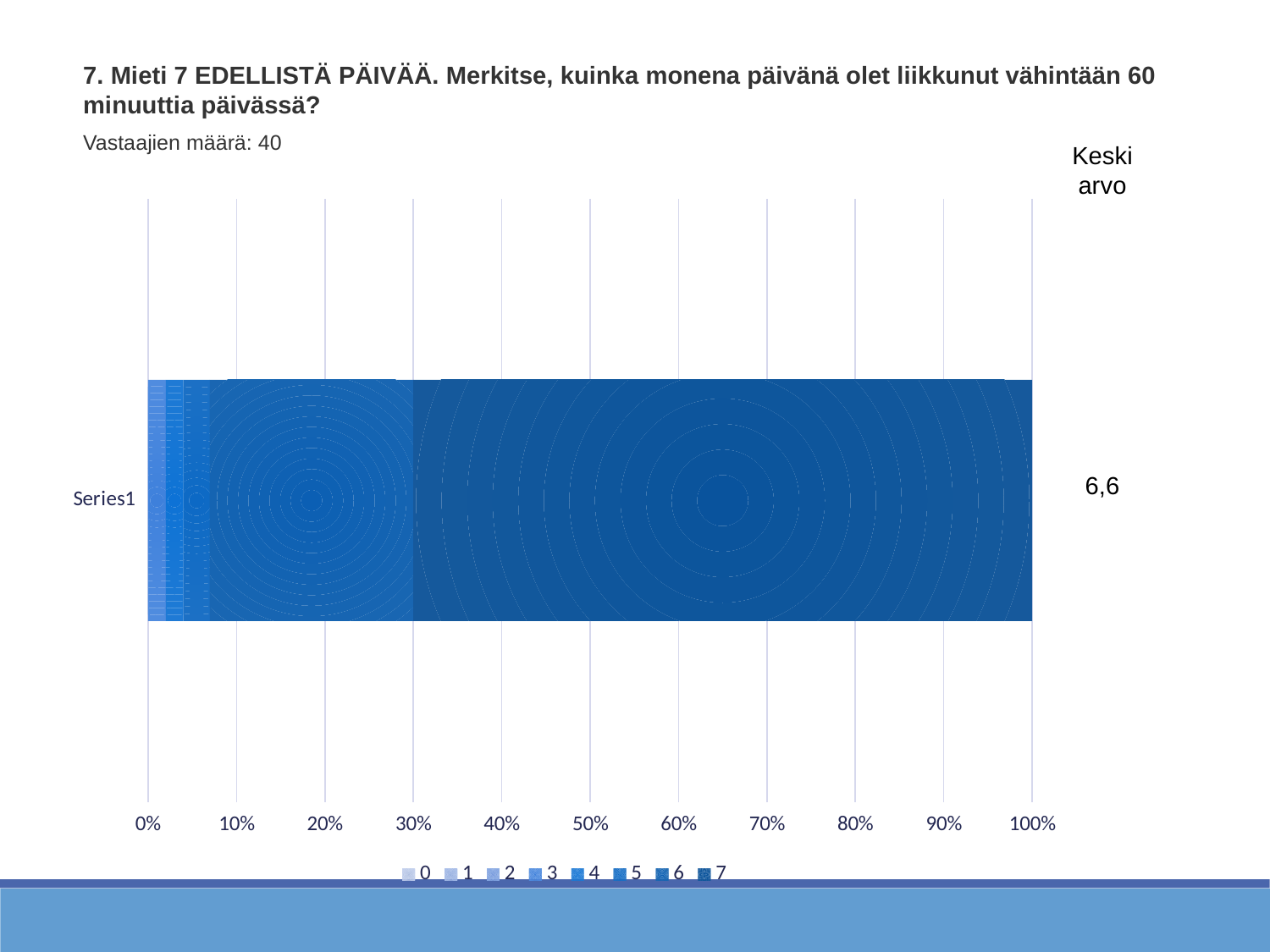
Is the share of series 7 in the Series1 bar greater or less than 50%? greater What is the highest value shown on the horizontal axis? 100% How many series does the legend list? 8 What mean value (Keski arvo) is shown next to the chart? 6,6 What kind of chart is shown on the slide? Stacked bar chart Which legend series takes up the largest share of the Series1 bar? 7 How many categories are plotted on the vertical axis? 1 Which is larger in the Series1 bar, the share of series 6 or the share of series 7? 7 What is the label of the single category on the vertical axis? Series1 How many respondents (Vastaajien määrä) are reported for this chart? 40 Is the share of series 6 in the Series1 bar greater or less than 30%? less